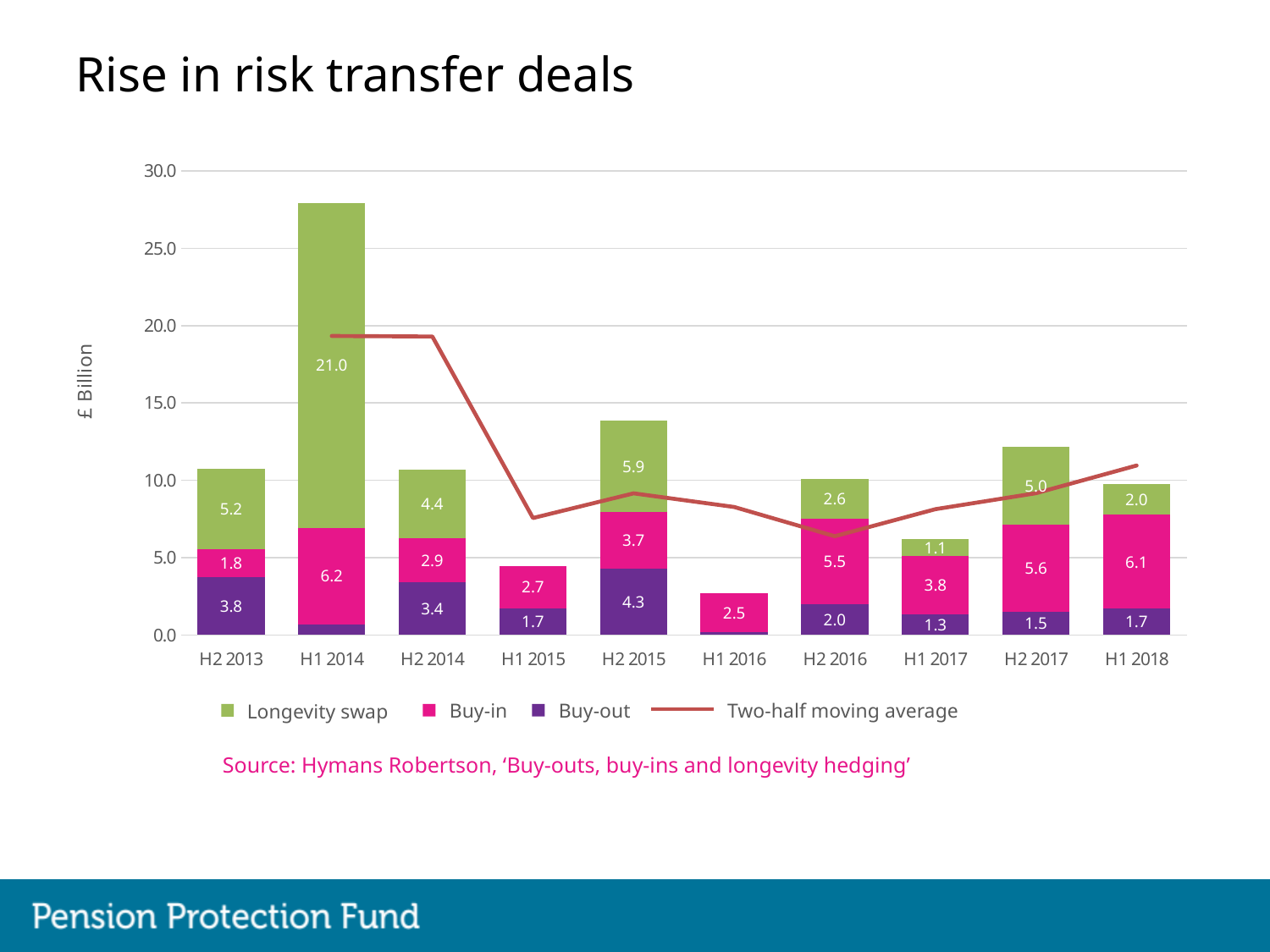
Is the Two-half moving average value for H1 2014 greater or less than 15.0? greater Which period has the highest Buy-out value? H2 2015 Which period has the lowest labelled Buy-in value? H2 2013 What is the difference between the Buy-in values for H2 2017 and H1 2017? 1.8 What kind of chart is shown on the slide? stacked bar chart with a line (combination bar and line chart) What is the Buy-in value for H1 2018? 6.1 Which is larger, the Longevity swap value for H2 2013 or for H2 2014? H2 2013 How many periods are shown on the x axis? 10 What is the Longevity swap value for H1 2014? 21.0 How many entries does the legend list? 4 What is the label on the y axis? £ Billion What is the total of the stacked bar for H2 2015? 13.9